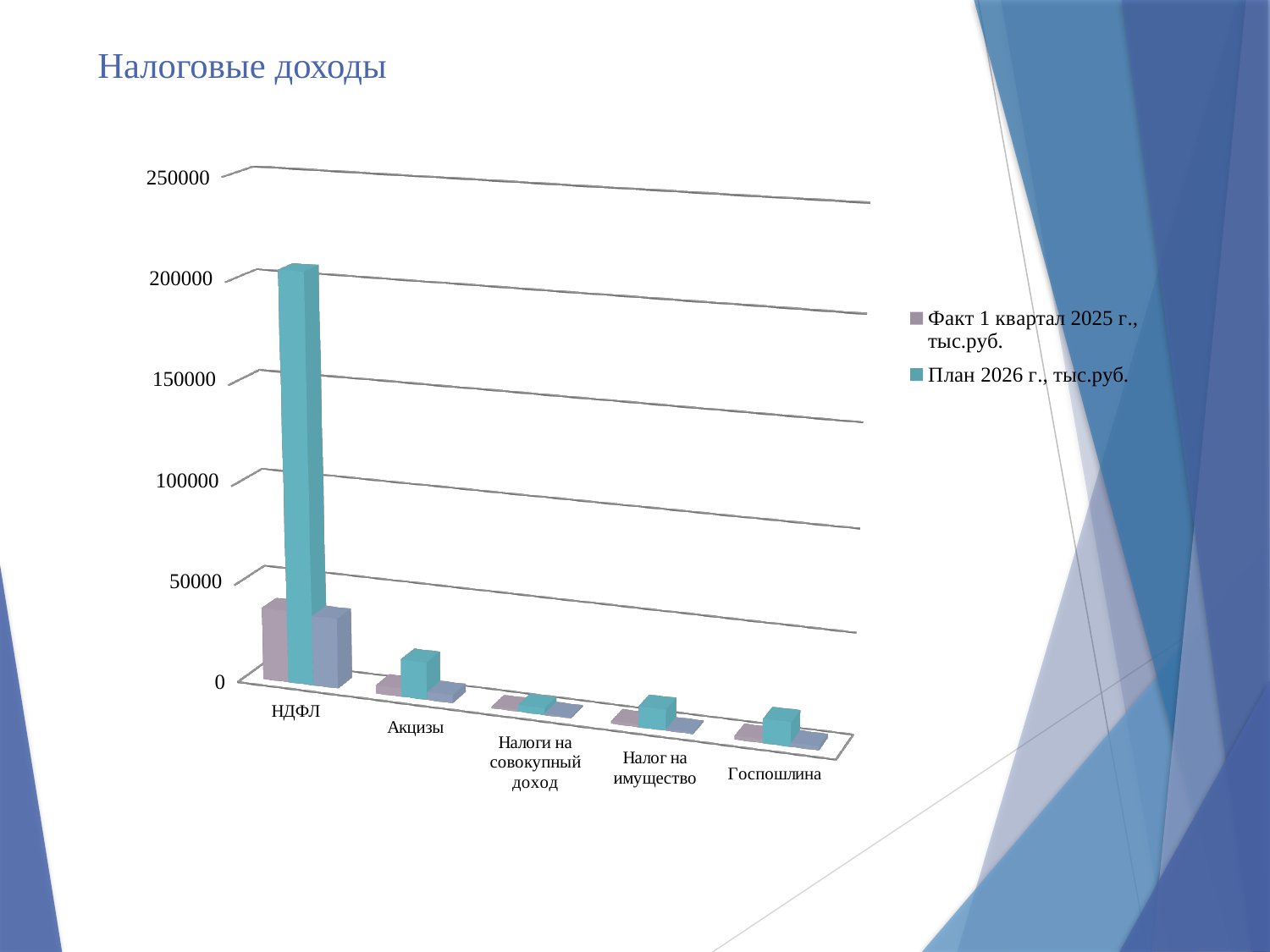
What is the title of the chart? Налоговые доходы Is the value for НДФЛ in the План 2026 г., тыс.руб. series greater or less than 150000? greater How many series does the legend list? 2 Which category has the lowest value for План 2026 г., тыс.руб.? Налоги на совокупный доход For НДФЛ, which is larger: Факт 1 квартал 2025 г., тыс.руб. or План 2026 г., тыс.руб.? План 2026 г., тыс.руб. How many categories are shown on the x axis? 5 What kind of chart is shown on the slide? bar chart Which series is shown in teal in the legend? План 2026 г., тыс.руб. Which category has the highest value for План 2026 г., тыс.руб.? НДФЛ Is the value for Акцизы in the План 2026 г., тыс.руб. series greater or less than 50000? less Which category has the highest value for Факт 1 квартал 2025 г., тыс.руб.? НДФЛ Is the value for НДФЛ in the Факт 1 квартал 2025 г., тыс.руб. series greater or less than 50000? less